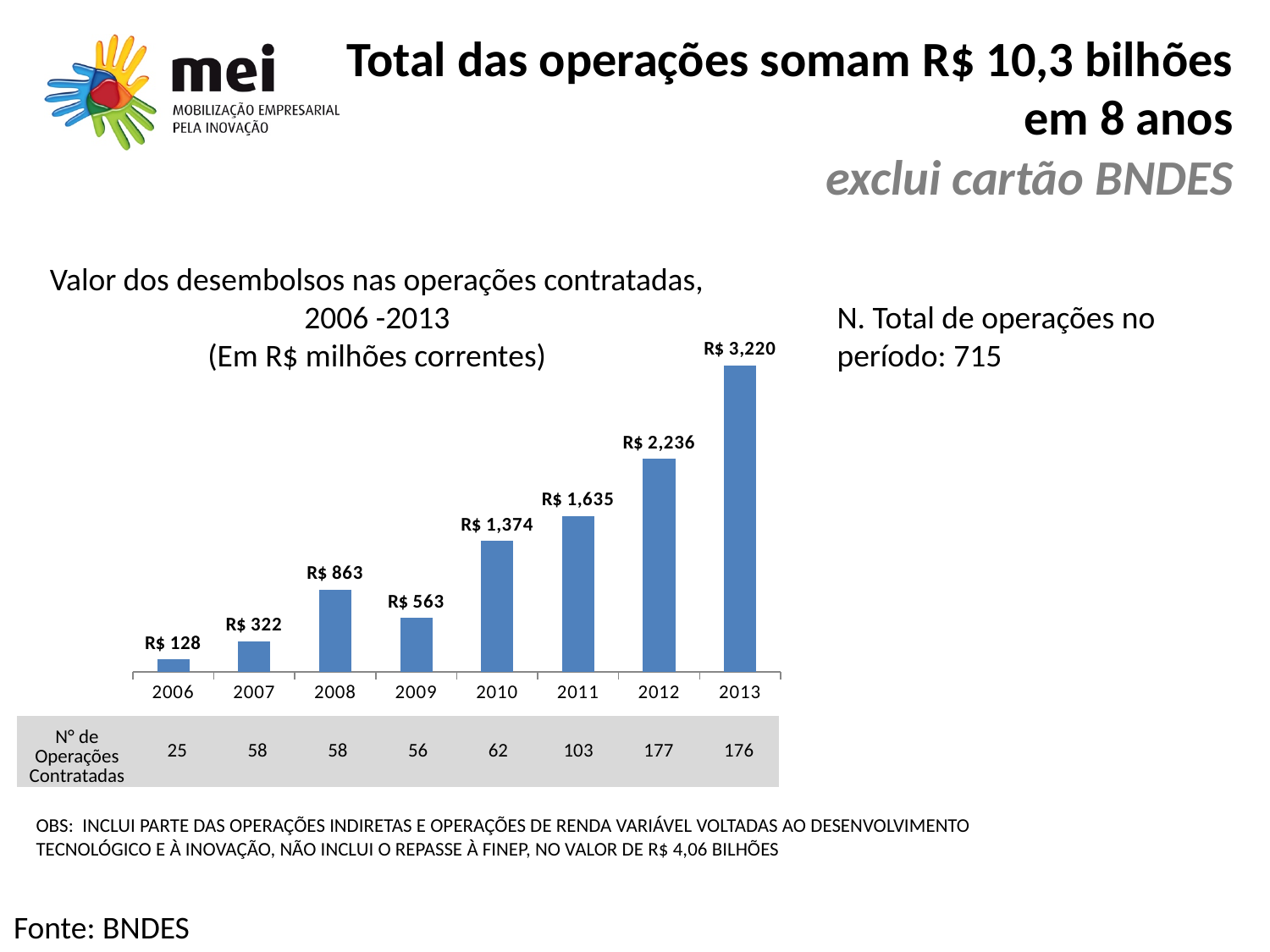
What is the value for 2013? R$ 3,220 What is the title of the chart? Valor dos desembolsos nas operações contratadas, 2006 -2013 (Em R$ milhões correntes) What kind of chart is this? bar chart Do the values rise or fall from 2009 to 2013? rise What is the value for 2009? R$ 563 Which year has the lowest value? 2006 How many years are shown on the x axis? 8 What is the difference between the values for 2008 and 2009? R$ 300 What is the difference between the values for 2013 and 2012? R$ 984 Which year has the highest value? 2013 Which is larger, the value for 2008 or the value for 2009? 2008 What is the value for 2006? R$ 128